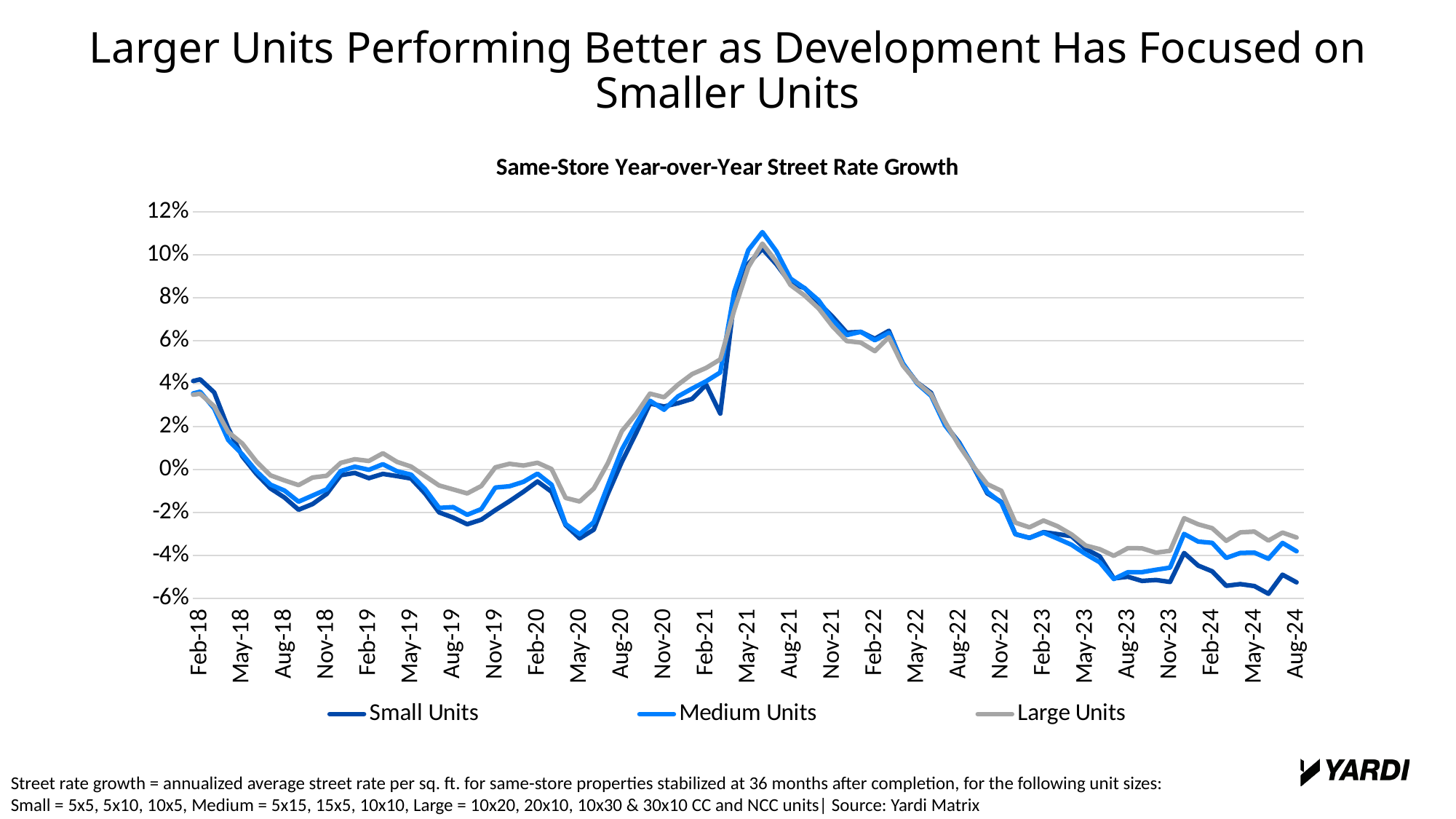
What kind of chart is shown on the slide? Line chart Is the value for Small Units at Aug-24 greater or less than -4%? less Do the values for all three series rise or fall between May-21 and Aug-23? fall Which series has the lowest value at Aug-24? Small Units At Aug-24, which is larger: the value for Large Units or the value for Small Units? Large Units How many series does the legend list? 3 Do the values for Small Units rise or fall between May-20 and May-21? rise What is the title of the chart? Same-Store Year-over-Year Street Rate Growth Which series reaches the highest value at its peak around May-21? Medium Units Is the value for Large Units at Aug-24 greater or less than -4%? greater Which series is drawn in grey? Large Units